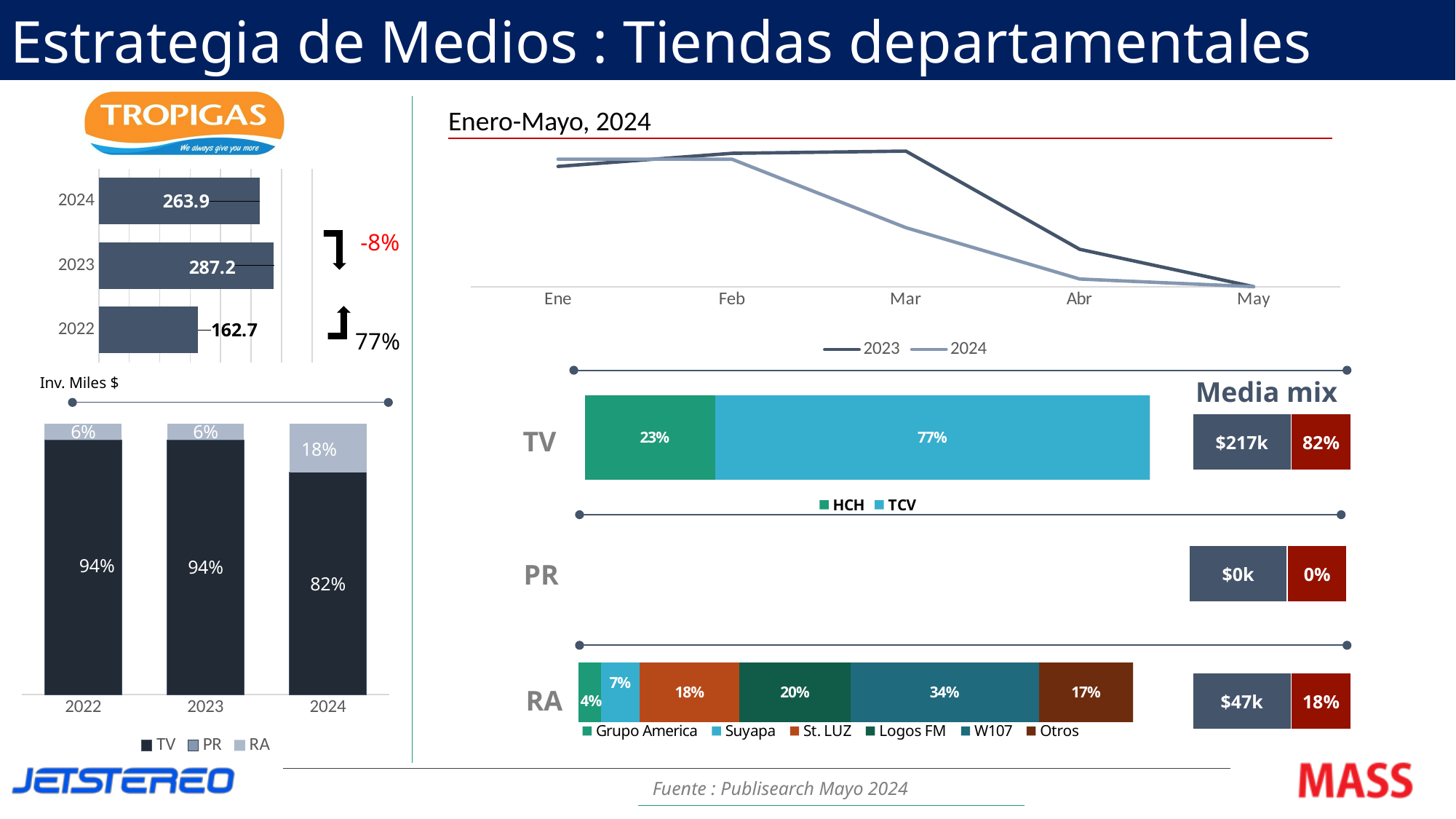
In the TV stacked bar on the right, what is the share for TCV? 77% In the horizontal bar chart at the top left (Inv. Miles $), which year has the lowest value? 2022 In the line chart titled Enero-Mayo, 2024, how many months are shown on the x axis? 5 How many series does the legend of the stacked bar chart at the bottom left list? 3 In the stacked bar chart at the bottom left, what is the TV share for 2024? 82% In the horizontal bar chart at the top left (Inv. Miles $), what is the value for 2023? 287.2 In the horizontal bar chart at the top left (Inv. Miles $), which is larger, the value for 2022 or the value for 2024? 2024 In the stacked bar chart at the bottom left, what is the RA share for 2022? 6% In the RA stacked bar on the right, which station has the highest share? W107 In the RA stacked bar on the right, what is the difference between the shares of Logos FM and Suyapa? 13% In the line chart titled Enero-Mayo, 2024, do the values rise or fall from Mar to May? fall In the horizontal bar chart at the top left (Inv. Miles $), what is the difference between the 2023 and 2024 values? 23.3